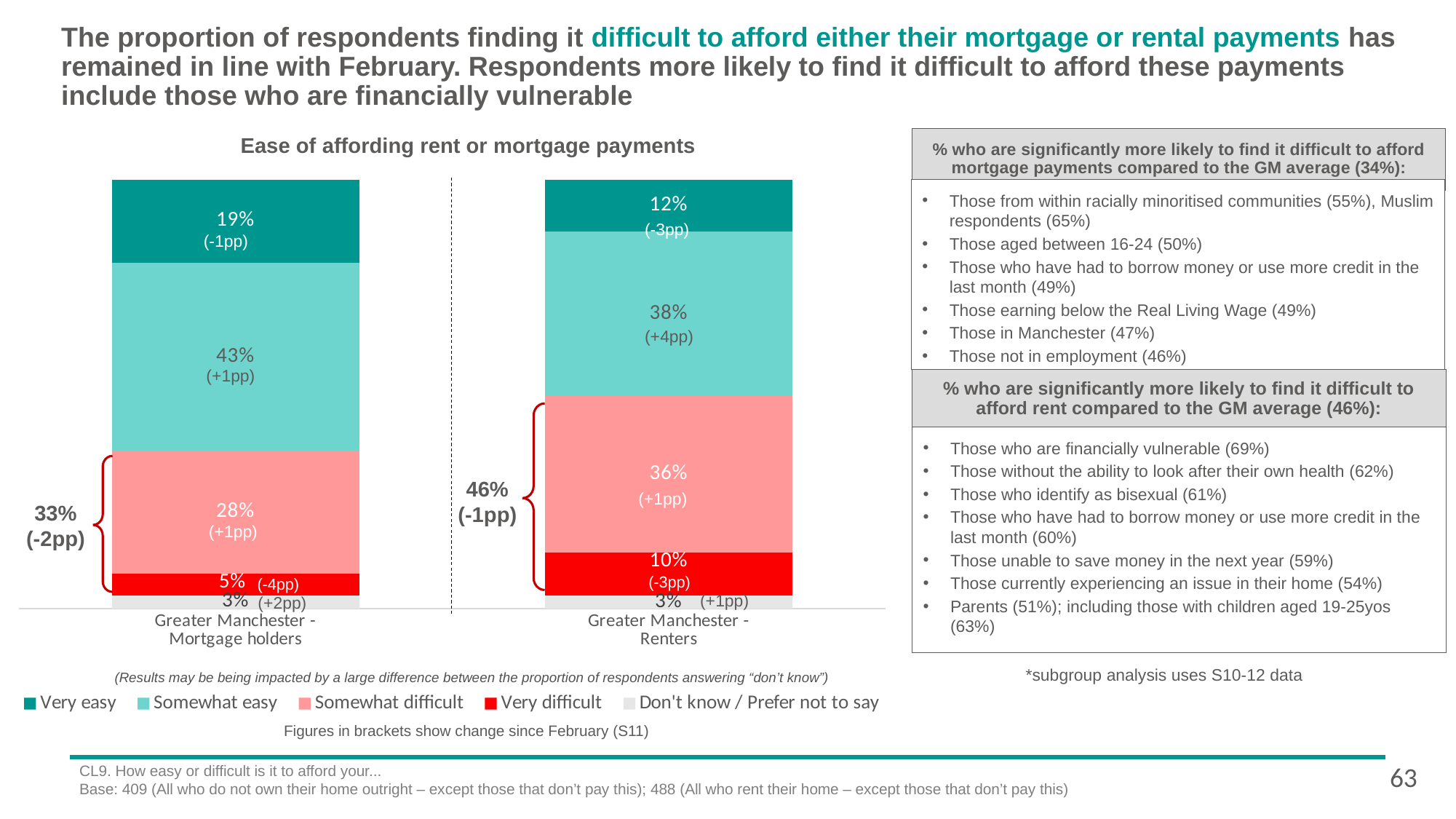
What percentage of Greater Manchester mortgage holders said it was very easy to afford their payments? 19% What is the 'Somewhat easy' value for Greater Manchester - Mortgage holders? 43% What type of chart is used to show ease of affording rent or mortgage payments? Stacked bar chart What is the change since February shown for 'Somewhat easy' among renters? +4pp Which group has the larger 'Very difficult' share: mortgage holders or renters? Renters What combined percentage of renters found it difficult (somewhat or very) to afford their payments, as shown by the bracket? 46% Which response category is the largest segment for Greater Manchester - Mortgage holders? Somewhat easy How many response categories does the legend list? 5 How many percentage points higher is the 'Somewhat easy' value for mortgage holders than for renters? 5 percentage points How many groups (bars) are shown in the chart? 2 What is the 'Very difficult' value for Greater Manchester - Renters? 10% What percentage of Greater Manchester renters found it somewhat difficult to afford their payments? 36%